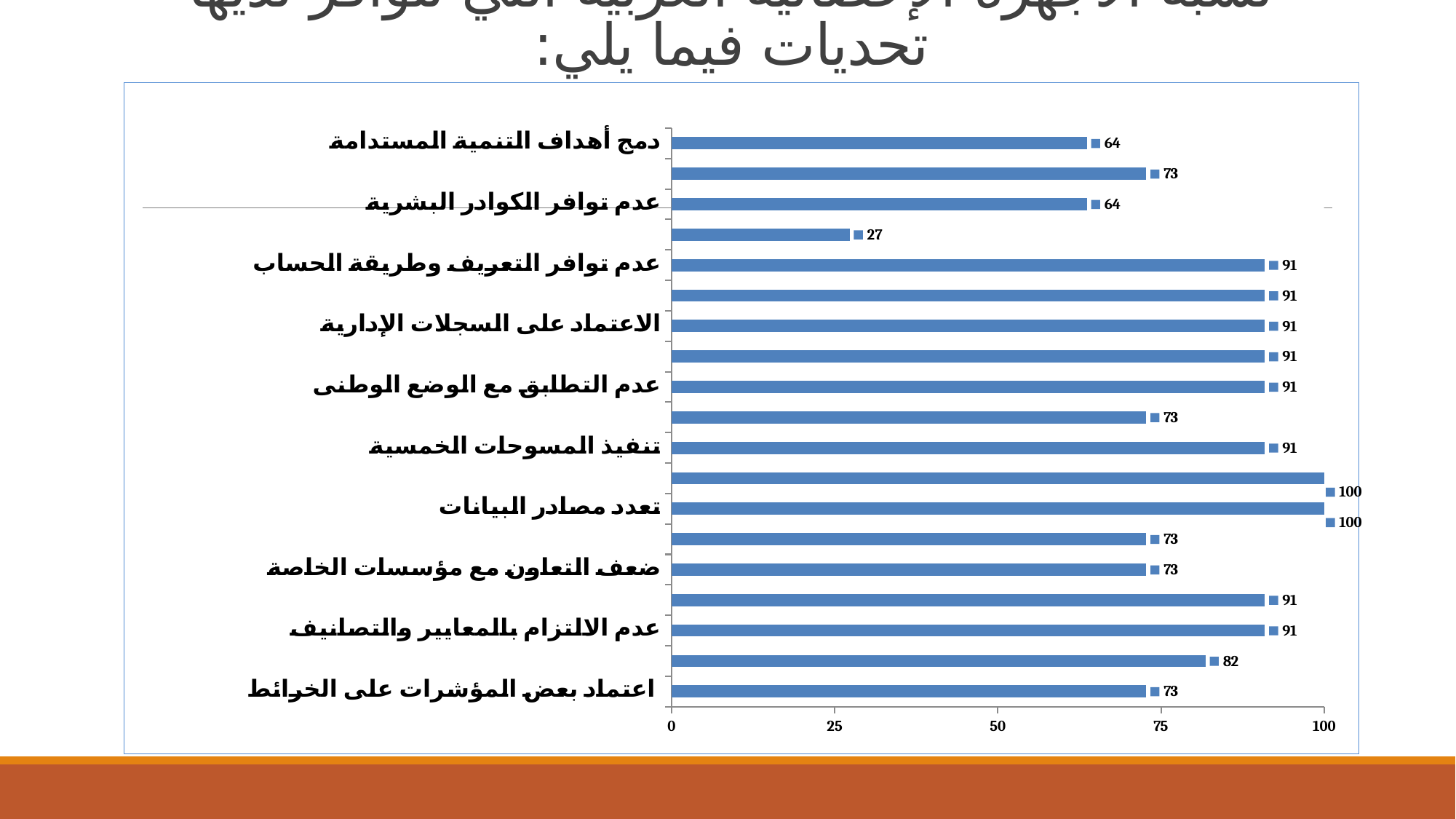
What type of chart is shown on the slide? bar chart What is the value for عدم الالتزام بالمعايير والتصنيف? 91 How many bars are plotted in the chart? 19 What is the value for اعتماد بعض المؤشرات على الخرائط? 73 What is the value for ضعف التعاون مع مؤسسات الخاصة? 73 Which is larger, the value for الاعتماد على السجلات الإدارية or the value for ضعف التعاون مع مؤسسات الخاصة? الاعتماد على السجلات الإدارية What is the value for تعدد مصادر البيانات? 100 What is the difference between the value for تعدد مصادر البيانات and the value for دمج أهداف التنمية المستدامة? 36 What is the smallest value shown by any bar in the chart? 27 What is the value for دمج أهداف التنمية المستدامة? 64 What is the largest value shown by any bar in the chart? 100 What is the value for عدم توافر الكوادر البشرية? 64